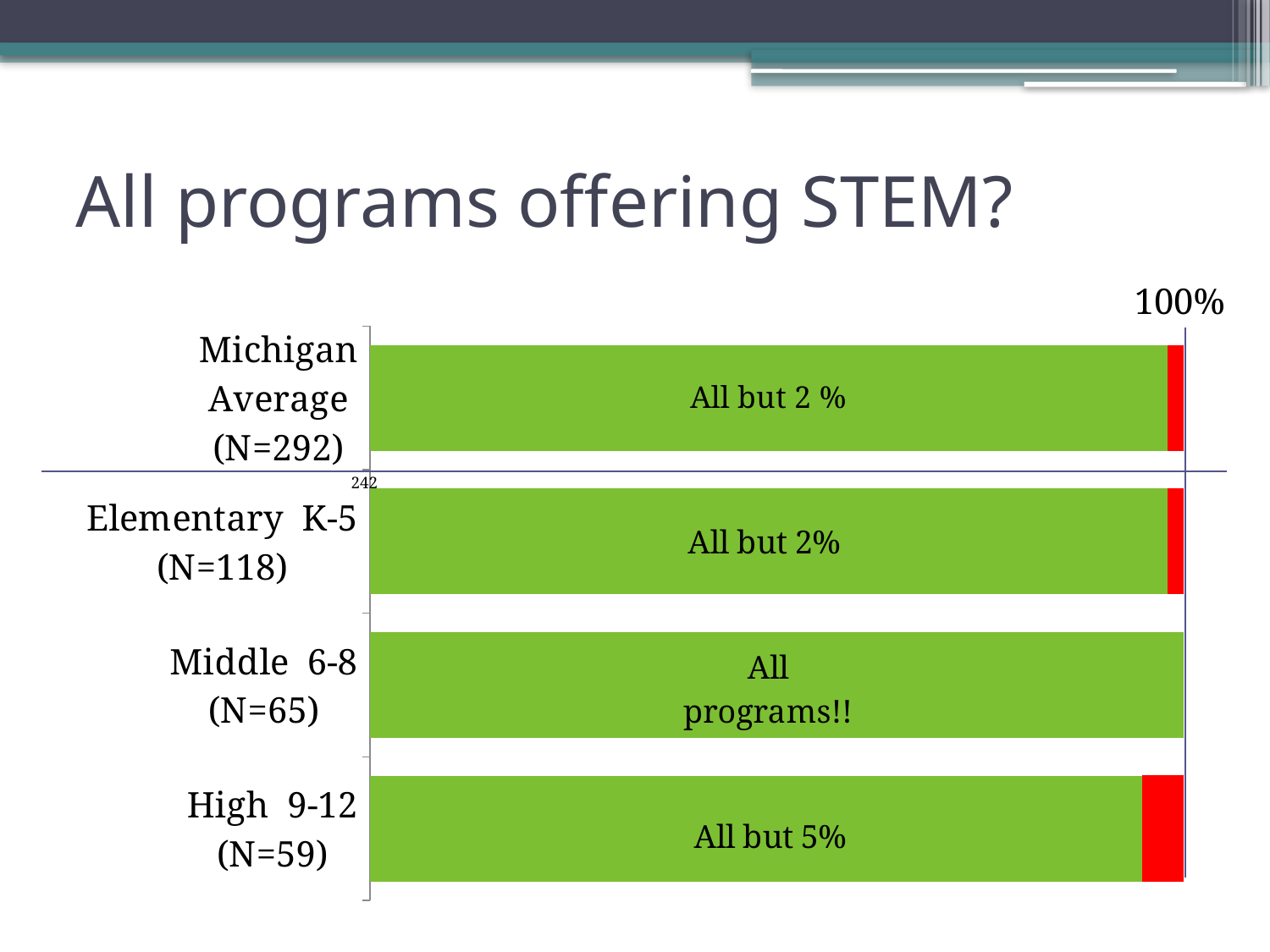
Which category has no red segment at all? Middle 6-8 (N=65) What value is marked at the right end of the horizontal axis? 100% What label is printed on the bar for Middle 6-8 (N=65)? All programs!! What label is printed on the bar for Michigan Average (N=292)? All but 2 % What is the sample size (N) shown for the Michigan Average category? 292 How many categories (bars) does the chart show? 4 What label is printed on the bar for Elementary K-5 (N=118)? All but 2% What label is printed on the bar for High 9-12 (N=59)? All but 5% Which has a larger red segment: Elementary K-5 or High 9-12? High 9-12 Which category has the largest red segment (largest share of programs not offering STEM)? High 9-12 (N=59) What is the title of the slide containing the chart? All programs offering STEM? What kind of chart is shown on the slide? bar chart